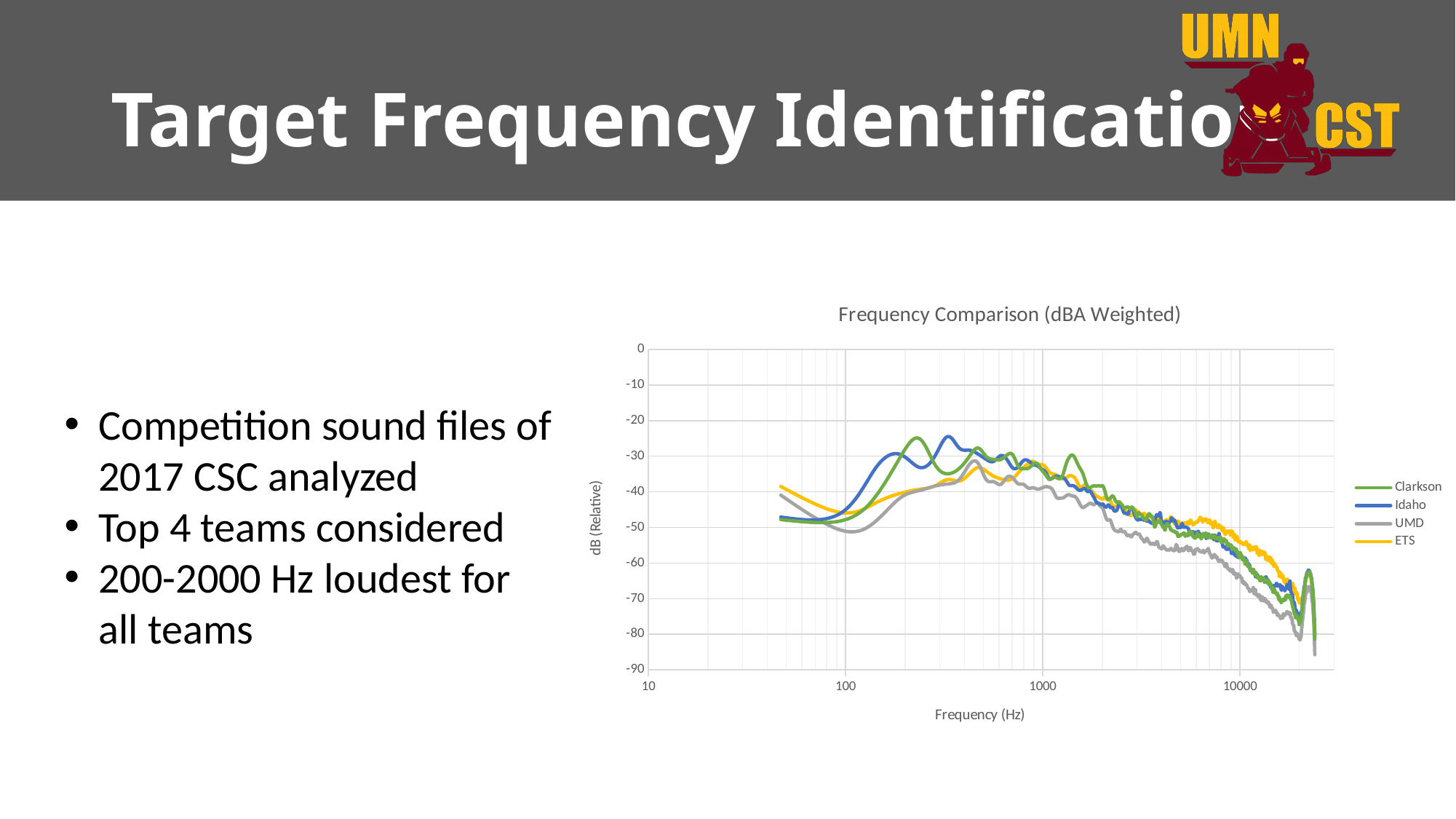
What kind of chart is shown on the slide? line chart Which series has the lowest value at 10000 Hz? UMD Is the value for UMD at 10000 Hz greater or less than -60 dB? less Which series has the lowest value at 100 Hz? UMD Is the peak value of the Clarkson series greater or less than -30 dB? greater At 10000 Hz, which series has the higher value, ETS or UMD? ETS Do the values of the series rise or fall as frequency increases from 1000 Hz to 10000 Hz? fall How many series does the legend of the chart list? 4 Is the value for UMD at 1000 Hz greater or less than -30 dB? less What is the title of the chart? Frequency Comparison (dBA Weighted) What is the label of the x axis of the chart? Frequency (Hz)